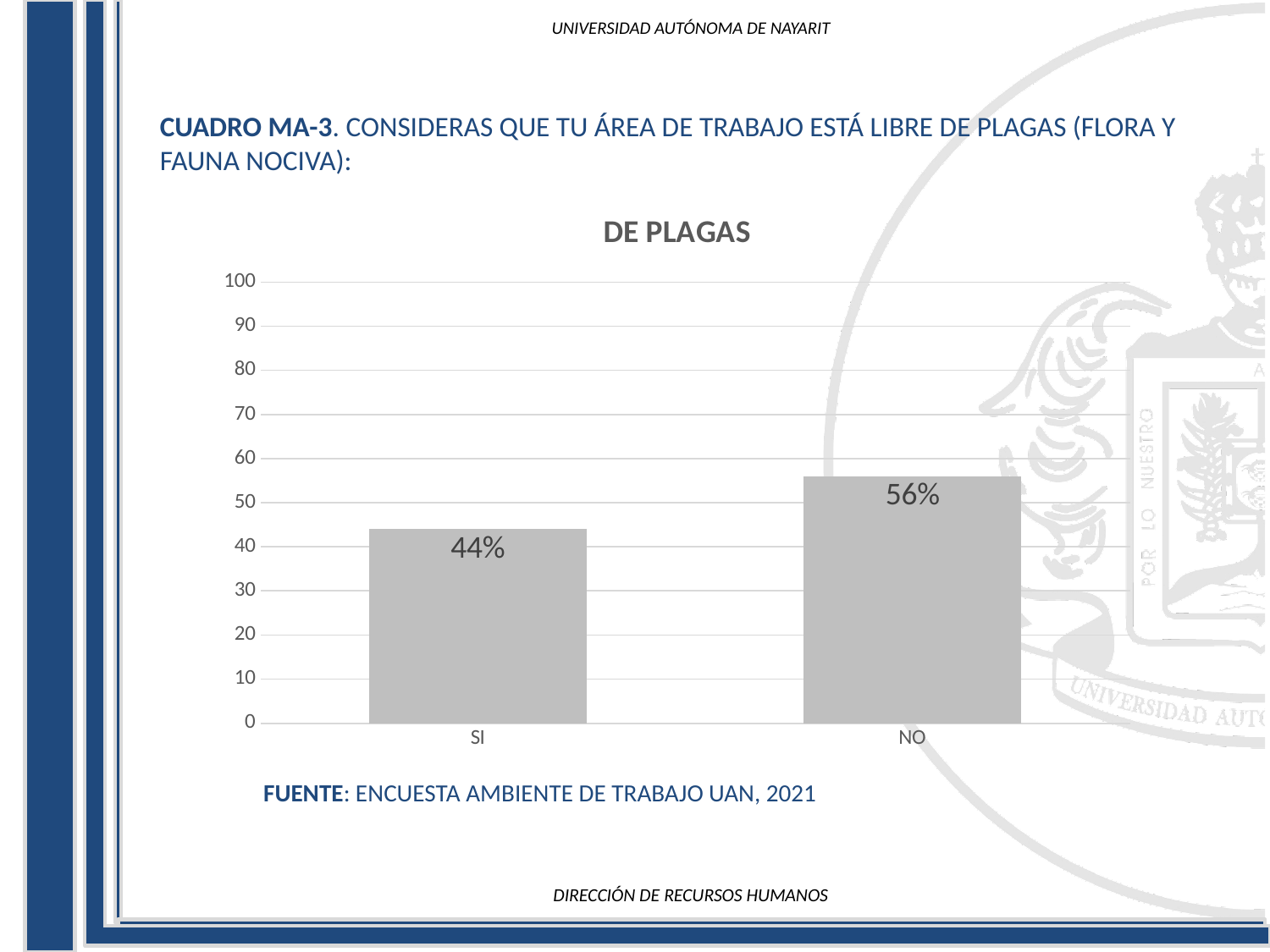
What is the difference between the values for NO and SI? 12% What is the highest value shown on the y axis? 100 Which is larger, the value for SI or the value for NO? NO What is the title of the chart? DE PLAGAS Is the value for SI greater or less than 50? less Is the value for NO greater or less than 50? greater Which category has the highest value? NO What kind of chart is shown on the slide? bar chart Which category has the lowest value? SI What is the value for SI? 44% What is the value for NO? 56% How many categories are shown on the x axis? 2